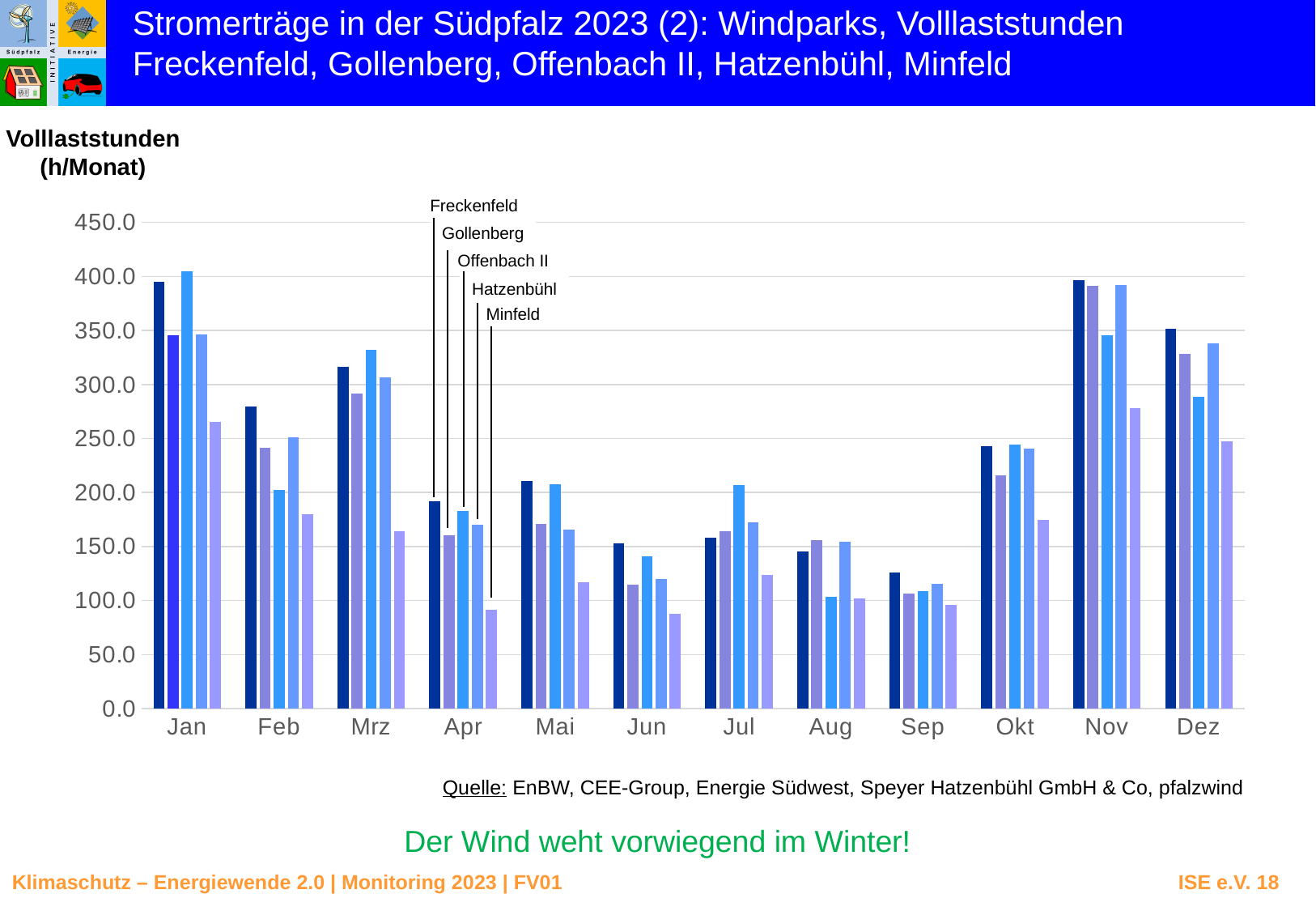
How many months are shown on the x axis of the chart? 12 Is the value for Freckenfeld in Jan greater or less than 350? greater In Jul, which is larger: the value for Offenbach II or for Hatzenbühl? Offenbach II In which month is the value for Freckenfeld lowest? Sep In which month is the value for Gollenberg highest? Nov What kind of chart is shown on the slide? bar chart How many wind parks (series) does the chart's legend list? 5 Which wind park has the lowest value in Jan? Minfeld Do the values for Freckenfeld rise or fall from Sep to Nov? rise Which is larger: the value for Freckenfeld in Jan or in Feb? Jan Is the value for Gollenberg in Nov greater or less than 350? greater Is the value for Minfeld in Apr greater or less than 100? less